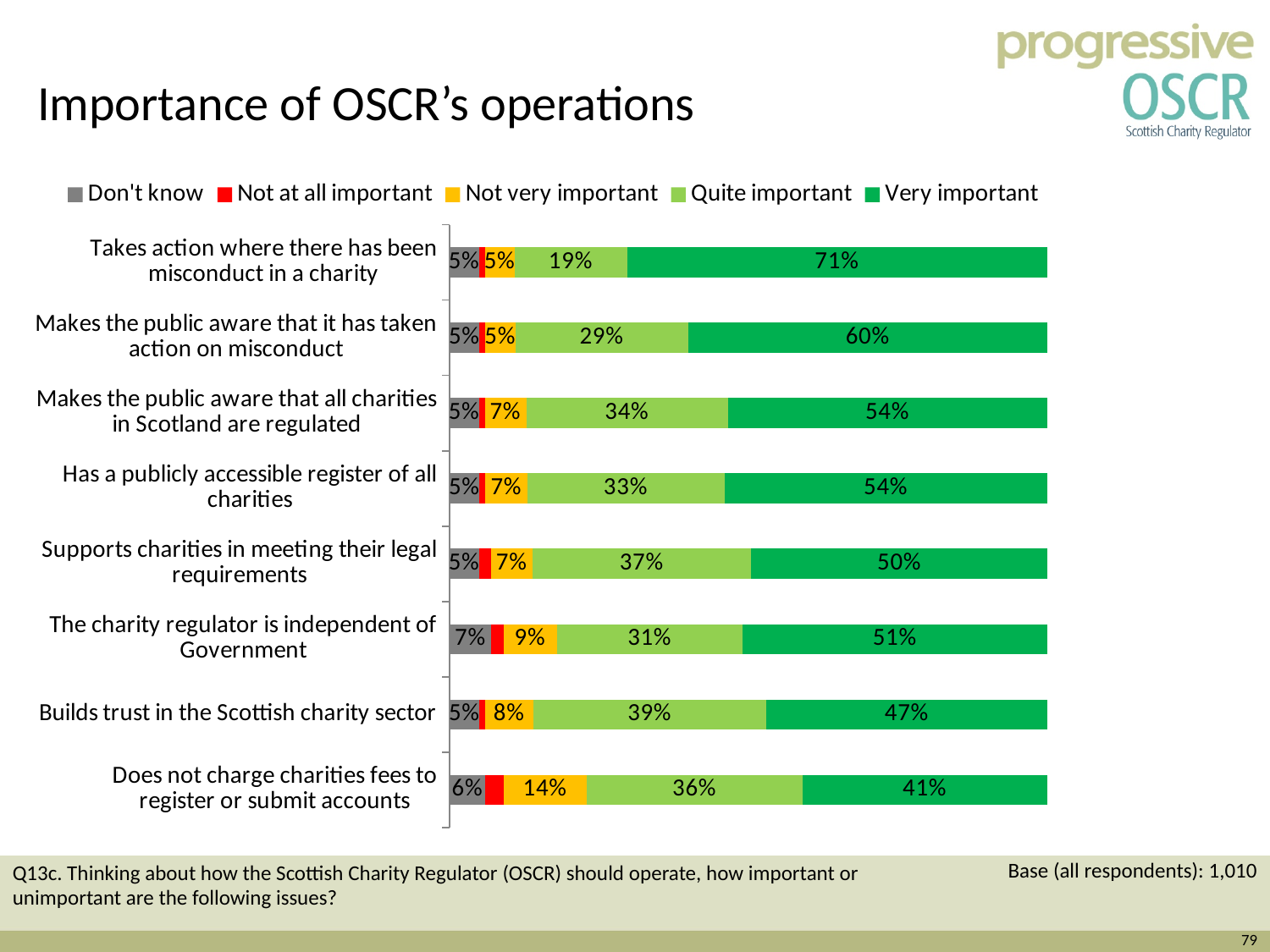
How many series does the legend list? 5 What percentage rated 'Takes action where there has been misconduct in a charity' as Very important? 71% Which item has the lowest Very important percentage? Does not charge charities fees to register or submit accounts What is the difference between the Very important percentages for 'Takes action where there has been misconduct in a charity' and 'Makes the public aware that it has taken action on misconduct'? 11% What percentage rated 'Does not charge charities fees to register or submit accounts' as Not very important? 14% Which has a larger Quite important value: 'Supports charities in meeting their legal requirements' or 'The charity regulator is independent of Government'? Supports charities in meeting their legal requirements Which item has the highest Very important percentage? Takes action where there has been misconduct in a charity What is the Quite important value for 'Builds trust in the Scottish charity sector'? 39% How many items (categories) are shown in the chart? 8 What type of chart is shown on the slide? Stacked bar chart What is the Don't know value for 'The charity regulator is independent of Government'? 7% Which legend entry is shown in red? Not at all important